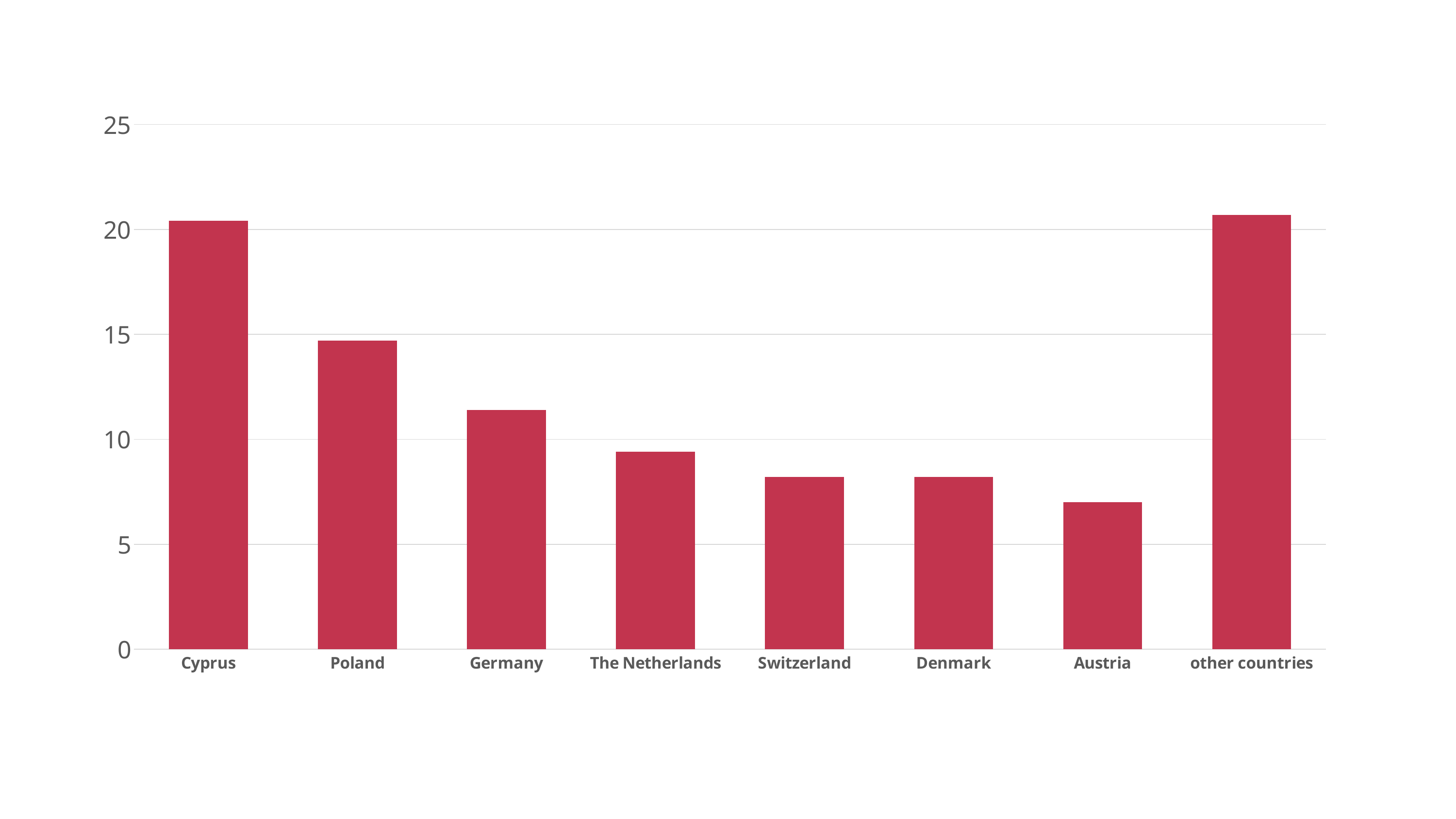
From Cyprus to Austria, do the values rise or fall along the x axis? fall Is the value for Poland greater or less than 10? greater Which is larger, the value for Austria or the value for The Netherlands? The Netherlands Is the value for Germany greater or less than 10? greater Which category has the lowest value? Austria Is the value for The Netherlands greater or less than 10? less Which is larger, the value for Poland or the value for Germany? Poland How many categories are shown on the x axis? 8 What kind of chart is shown on the slide? bar chart